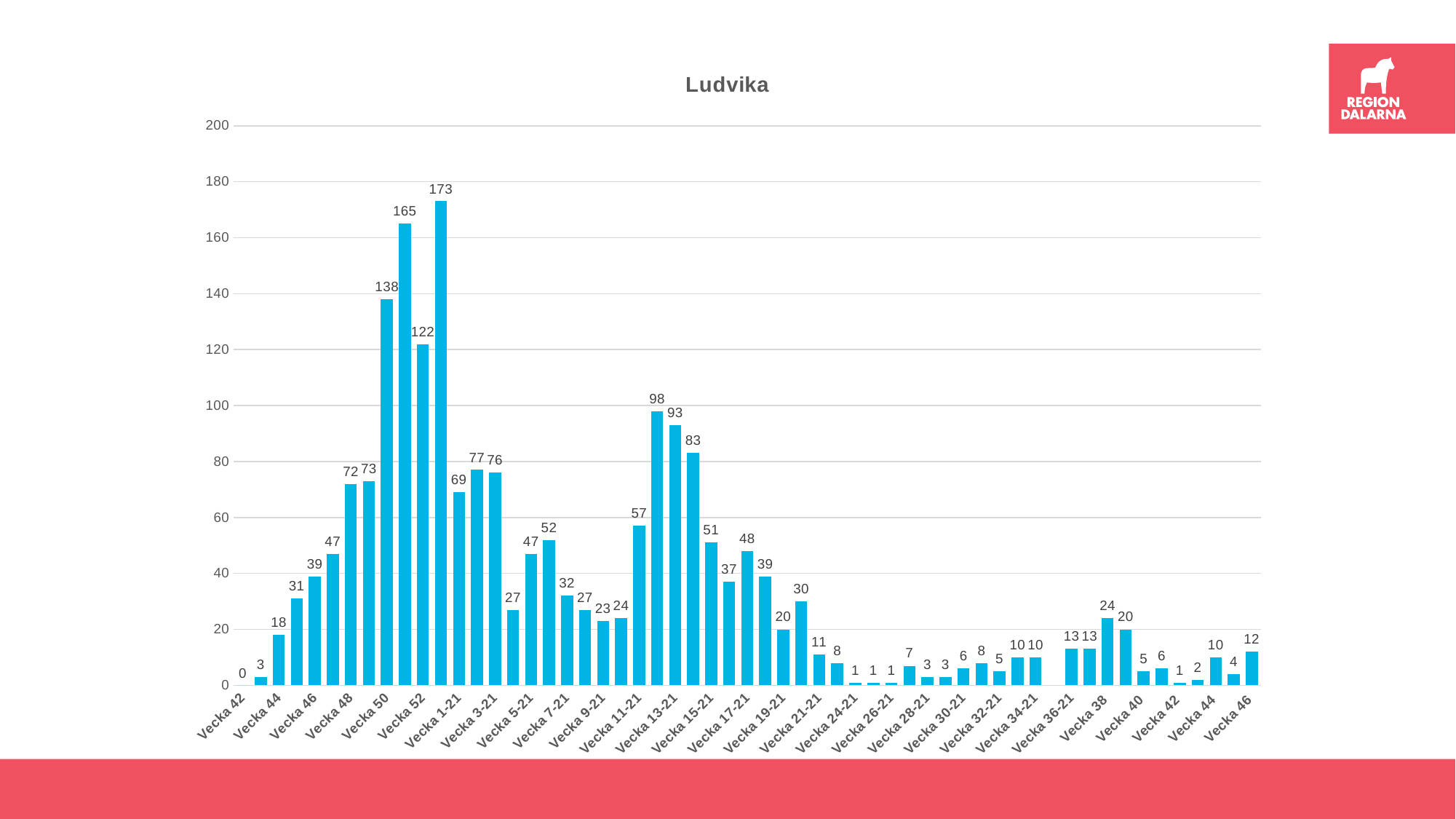
What is the difference between the values for Vecka 50 and Vecka 52? 16 What is the value for Vecka 13-21? 93 Which has the larger value, Vecka 48 or Vecka 3-21? Vecka 3-21 What is the value for Vecka 38? 24 What is the title of the chart? Ludvika What is the value for Vecka 50? 138 What is the value for Vecka 1-21? 69 What is the value for Vecka 34-21? 10 Do the values rise or fall from Vecka 44 to Vecka 50? rise What is the highest value shown in the chart? 173 Is the value for Vecka 11-21 greater or less than 40? greater What kind of chart is shown on the slide? bar chart